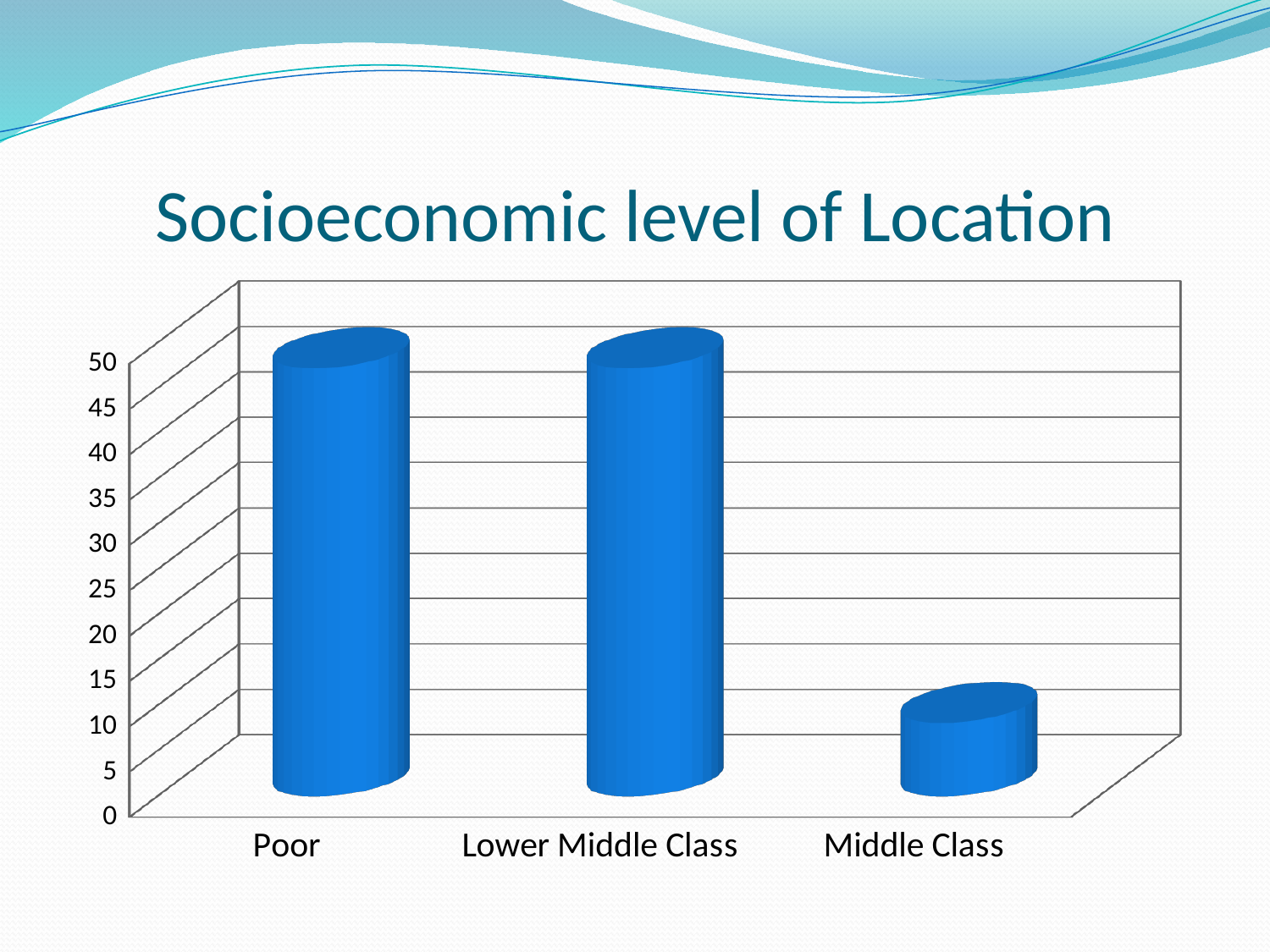
Which is larger, the value for Lower Middle Class or the value for Middle Class? Lower Middle Class What is the title of the chart? Socioeconomic level of Location Is the value for Poor greater or less than 40? greater What is the highest value shown on the vertical axis of the chart? 50 Which is larger, the value for Poor or the value for Middle Class? Poor Is the value for Middle Class greater or less than 5? greater What are the three categories listed on the x axis, from left to right? Poor, Lower Middle Class, Middle Class Is the value for Lower Middle Class greater or less than 40? greater What kind of chart is shown on the slide? Bar chart How many categories are shown on the x axis of the chart? 3 Which category has the lowest value in the chart? Middle Class